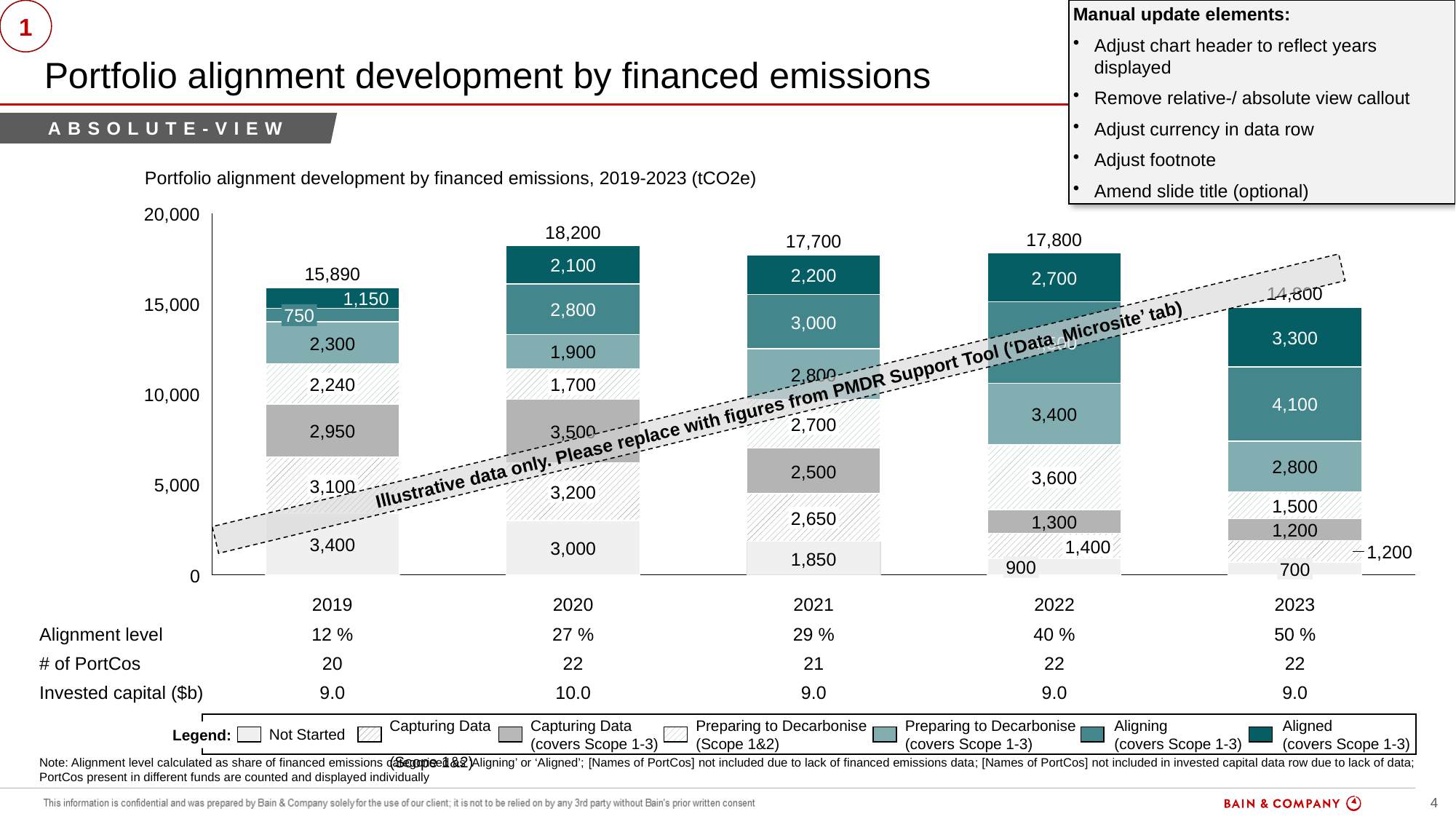
Which year has the highest total financed emissions? 2020 What is the difference between the total for 2020 and the total for 2023? 3,400 Which year has the lowest total financed emissions? 2023 What is the value of the Not Started segment in 2019? 3,400 What kind of chart is shown on the slide? Stacked bar chart Is the total for 2019 greater or less than 15,000? greater What is the total financed emissions shown for 2020? 18,200 What is the value of the Aligned (covers Scope 1-3) segment in 2023? 3,300 Is the Aligned (covers Scope 1-3) segment larger in 2021 or in 2022? 2022 Does the Aligned (covers Scope 1-3) segment rise or fall from 2019 to 2023? Rise How many years are shown on the x axis? 5 How many series does the legend list? 7